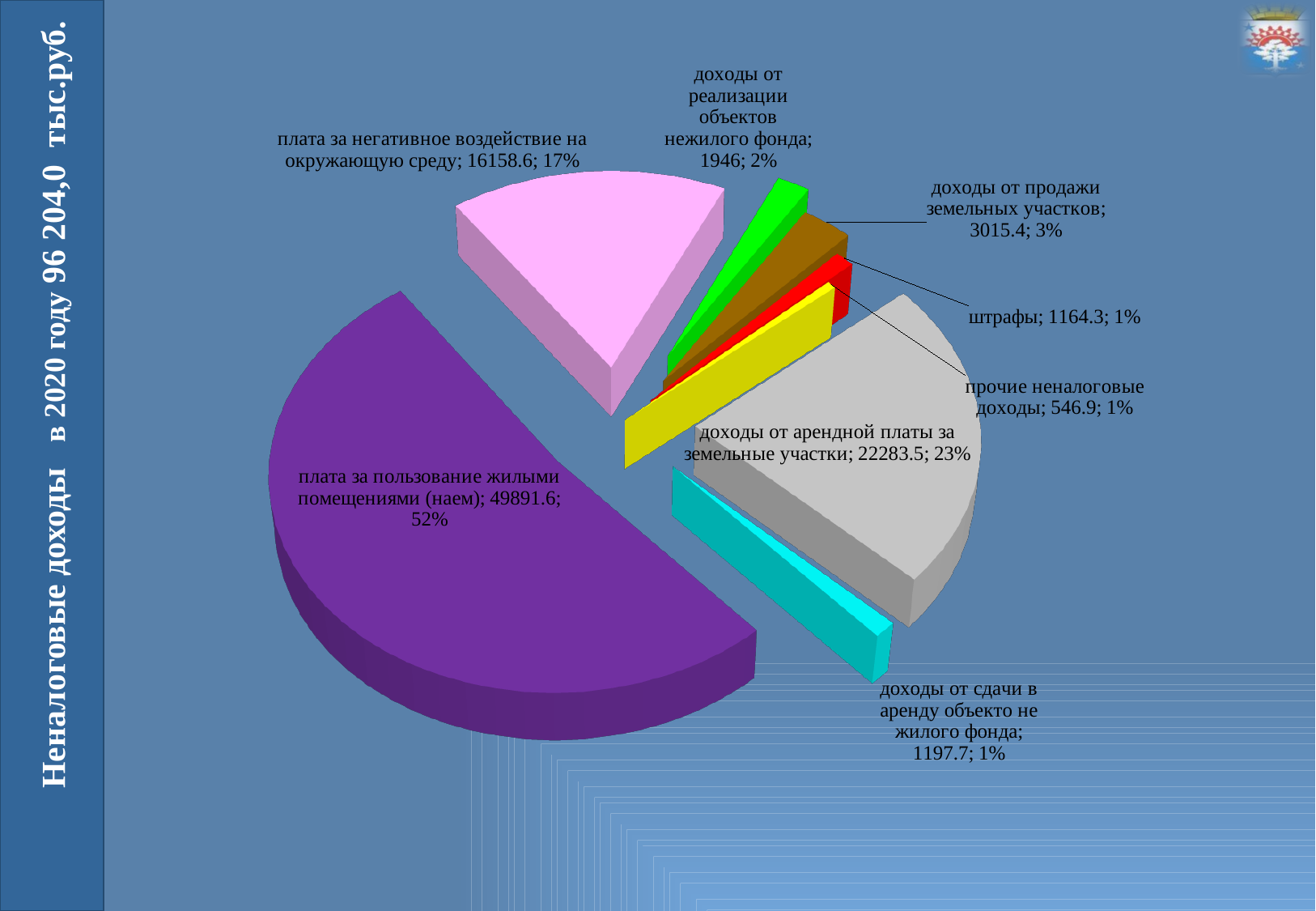
What is the difference between the values for «доходы от арендной платы за земельные участки» and «плата за негативное воздействие на окружающую среду»? 6124.9 What kind of chart is shown on the slide? pie chart Which is larger: the value for «доходы от реализации объектов нежилого фонда» or the value for «доходы от сдачи в аренду объекто не жилого фонда»? доходы от реализации объектов нежилого фонда Which category has the largest slice of the pie? плата за пользование жилыми помещениями (наем) What total amount of non-tax revenue for 2020 is stated in the slide title? 96 204,0 тыс.руб. What share of the pie does «плата за негативное воздействие на окружающую среду» represent? 17% What is the value for «доходы от арендной платы за земельные участки»? 22283.5 What is the value for «штрафы»? 1164.3 What share of the pie does «доходы от продажи земельных участков» represent? 3% What is the value for «плата за пользование жилыми помещениями (наем)»? 49891.6 Which category has the smallest slice of the pie? прочие неналоговые доходы How many slices does the pie chart have? 8